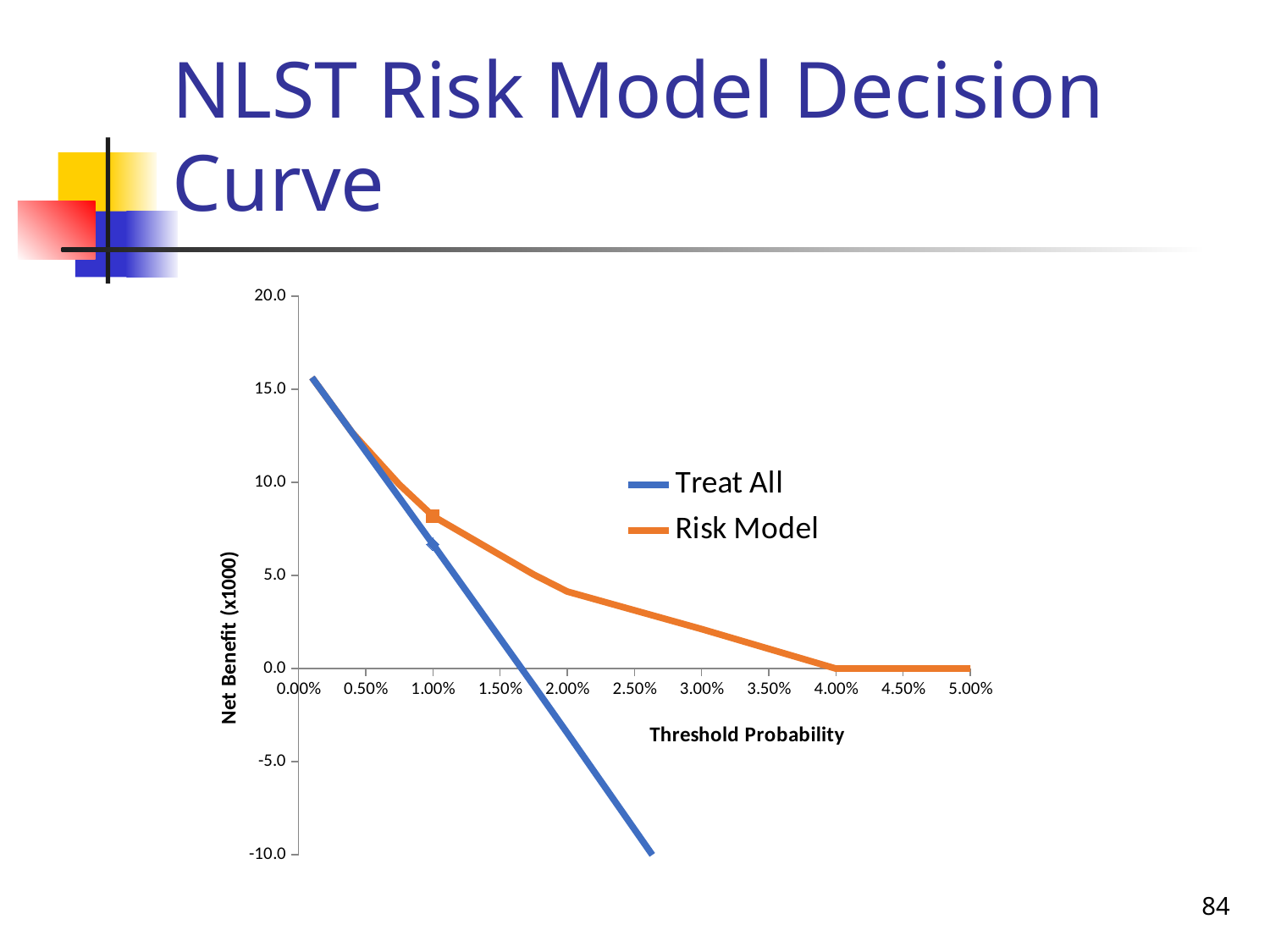
At a threshold probability of 3.00%, which series has the higher net benefit, Treat All or Risk Model? Risk Model Is the Risk Model value at 1.00% greater or less than 5.0? greater Is the Treat All value at 0.50% greater or less than 10.0? greater At a threshold probability of 2.00%, which series has the higher net benefit, Treat All or Risk Model? Risk Model Does the Treat All net benefit rise or fall as the threshold probability increases? fall What is the title of the x axis? Threshold Probability Is the Treat All value at 2.00% greater or less than 0.0? less What is the title of the y axis? Net Benefit (x1000) What is the Risk Model net benefit at a threshold probability of 5.00%? 0.0 What kind of chart is shown on the slide? line chart How many series does the legend list? 2